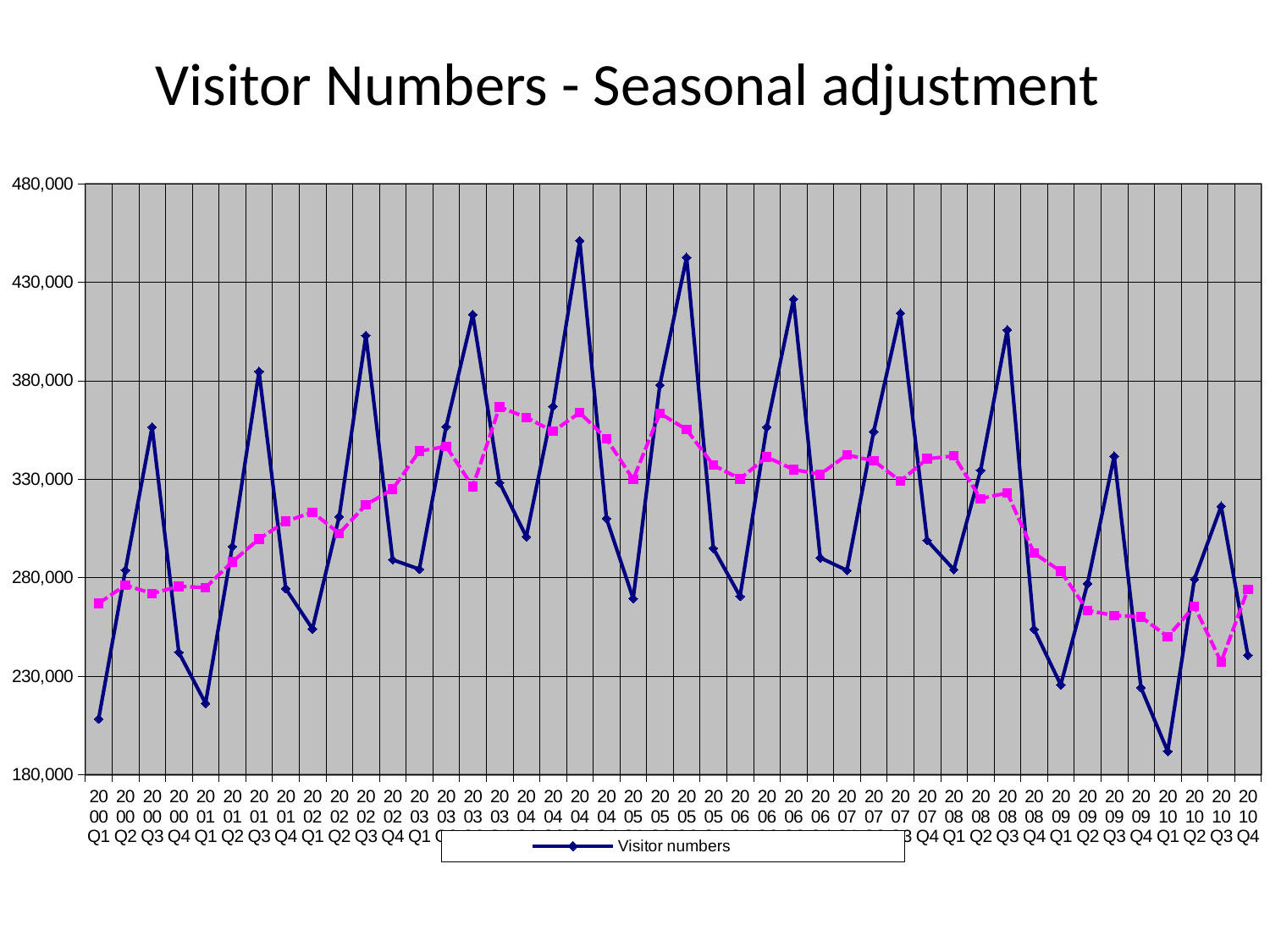
Is the Visitor numbers value for 2002 Q3 greater or less than 380,000? greater What series name is shown in the chart's legend? Visitor numbers Is the Visitor numbers value for 2004 Q3 greater or less than 430,000? greater Do the Q3 peaks of the Visitor numbers line rise or fall from 2006 Q3 to 2010 Q3? fall What kind of chart is shown on the slide? line chart Is the Visitor numbers value for 2010 Q1 greater or less than 230,000? less Which quarter has the highest value on the Visitor numbers line? 2004 Q3 Which is larger on the Visitor numbers line, the value for 2004 Q3 or the value for 2008 Q3? 2004 Q3 Which quarter has the lowest value on the Visitor numbers line? 2010 Q1 What is the title of the chart? Visitor Numbers - Seasonal adjustment How many quarterly points are plotted along the x axis? 44